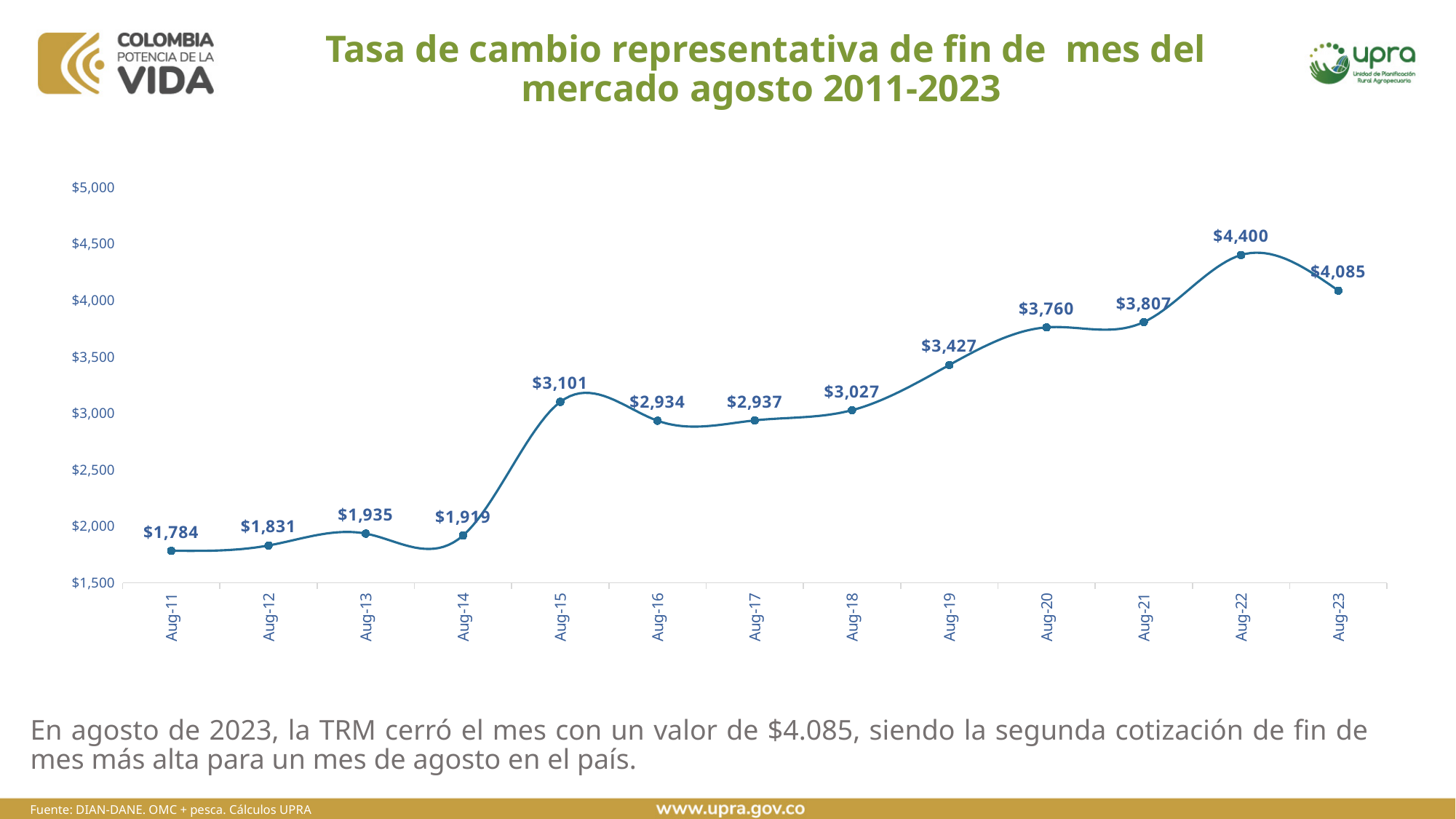
Do the values generally rise or fall from Aug-11 to Aug-22? rise Is the value for Aug-20 greater or less than $3,500? greater Which point has the lowest value? Aug-11 What is the value for Aug-11? $1,784 What kind of chart is shown on the slide? line chart What is the value for Aug-23? $4,085 Which is larger, the value for Aug-13 or the value for Aug-14? Aug-13 What is the difference between the values for Aug-15 and Aug-14? $1,182 What is the value for Aug-15? $3,101 Which point has the highest value? Aug-22 How many data points are plotted on the chart? 13 What is the difference between the values for Aug-22 and Aug-23? $315